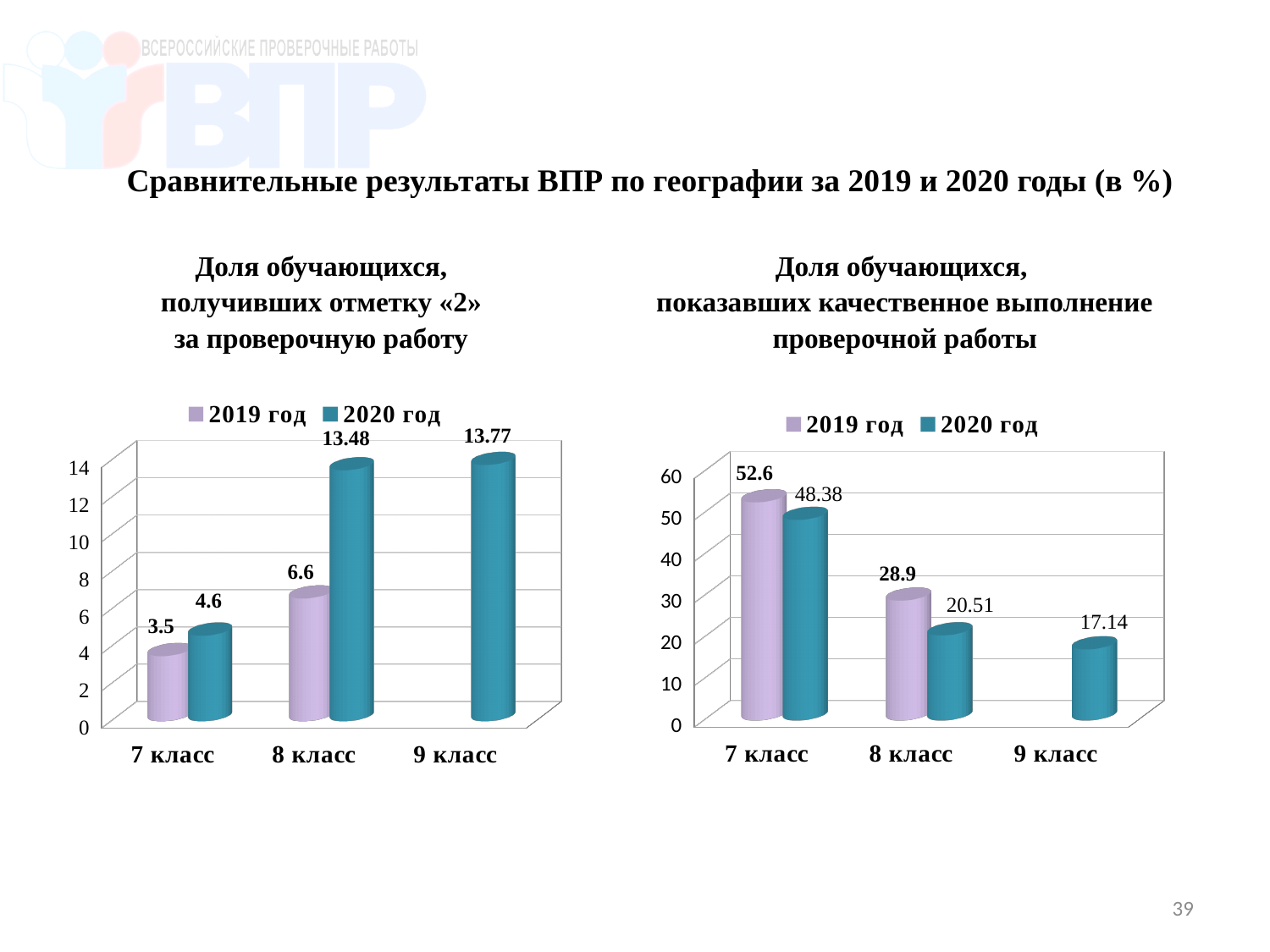
In the right chart, what is the difference between the 2019 год and 2020 год values for 8 класс? 8.39 In the right chart, which is larger for 7 класс: the 2019 год value or the 2020 год value? 2019 год In the right chart, which class has the lowest value for 2020 год? 9 класс In the left chart (share of students who received a '2'), what is the value for 8 класс in 2020 год? 13.48 In the left chart (share of students who received a '2'), what is the value for 7 класс in 2019 год? 3.5 How many class categories are shown on the x axis of the right chart? 3 In the right chart (share of students with quality performance), what is the value for 7 класс in 2019 год? 52.6 In the left chart, what is the difference between the 2020 год and 2019 год values for 8 класс? 6.88 In the right chart (share of students with quality performance), what is the value for 9 класс in 2020 год? 17.14 In the left chart, which class has the highest value for 2020 год? 9 класс What type of chart is the left chart? Bar chart How many series does the legend of the left chart list? 2